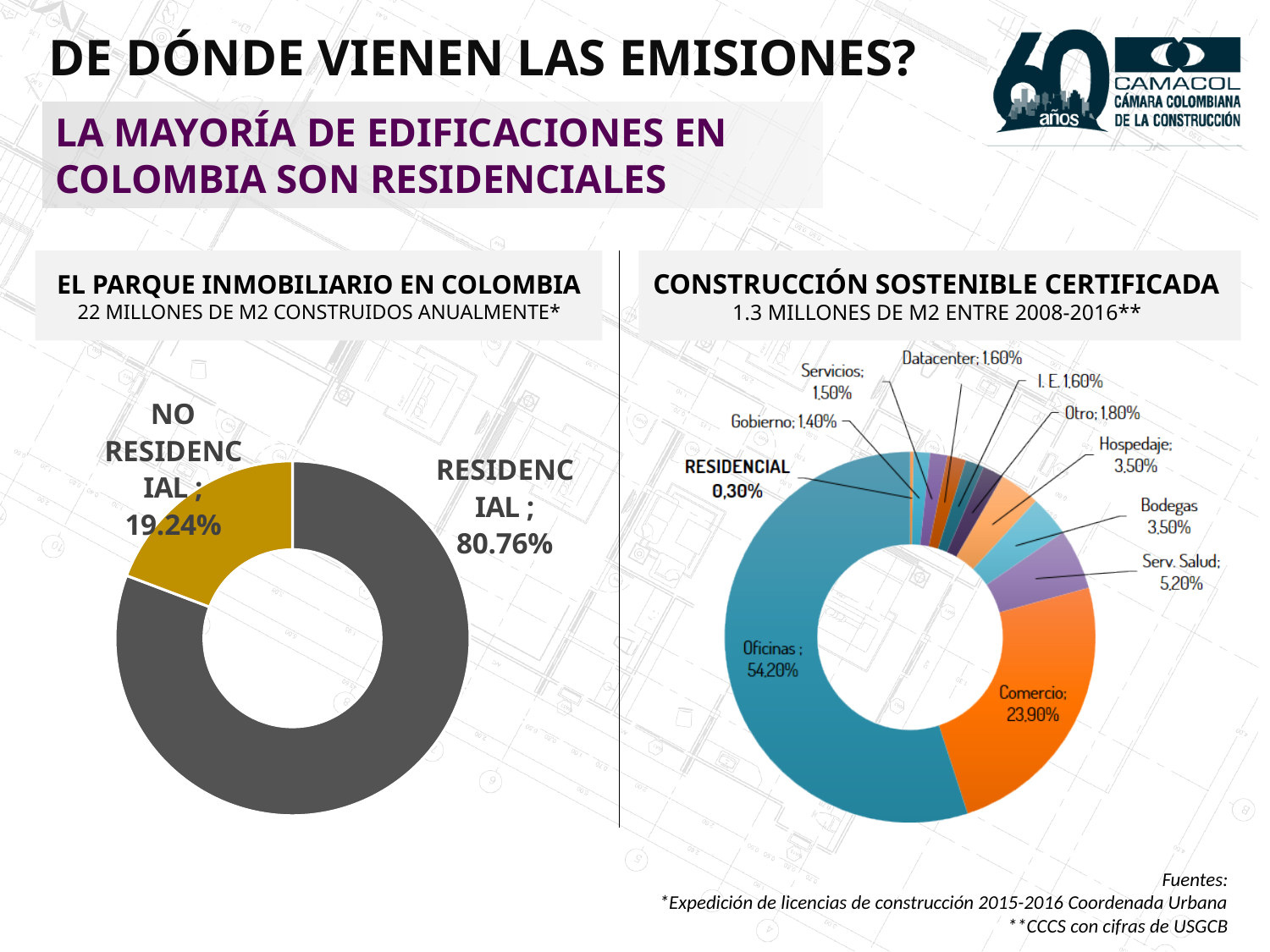
How many categories are shown in the chart titled CONSTRUCCIÓN SOSTENIBLE CERTIFICADA? 11 In the chart titled CONSTRUCCIÓN SOSTENIBLE CERTIFICADA, which is larger, Hospedaje or Serv. Salud? Serv. Salud In the chart titled CONSTRUCCIÓN SOSTENIBLE CERTIFICADA, which category has the largest share? Oficinas In the chart titled EL PARQUE INMOBILIARIO EN COLOMBIA, what share is NO RESIDENCIAL? 19.24% In the chart titled CONSTRUCCIÓN SOSTENIBLE CERTIFICADA, which category has the smallest share? RESIDENCIAL In the chart titled CONSTRUCCIÓN SOSTENIBLE CERTIFICADA, what is the value for Oficinas? 54,20% What kind of chart is the one titled EL PARQUE INMOBILIARIO EN COLOMBIA? Donut (pie) chart In the chart titled CONSTRUCCIÓN SOSTENIBLE CERTIFICADA, what is the value for Serv. Salud? 5,20% In the chart titled EL PARQUE INMOBILIARIO EN COLOMBIA, what is the difference between the RESIDENCIAL and NO RESIDENCIAL shares? 61.52% In the chart titled EL PARQUE INMOBILIARIO EN COLOMBIA, what share is RESIDENCIAL? 80.76% In the chart titled CONSTRUCCIÓN SOSTENIBLE CERTIFICADA, what is the difference between Oficinas and Comercio? 30,30% In the chart titled CONSTRUCCIÓN SOSTENIBLE CERTIFICADA, what is the value for Comercio? 23,90%